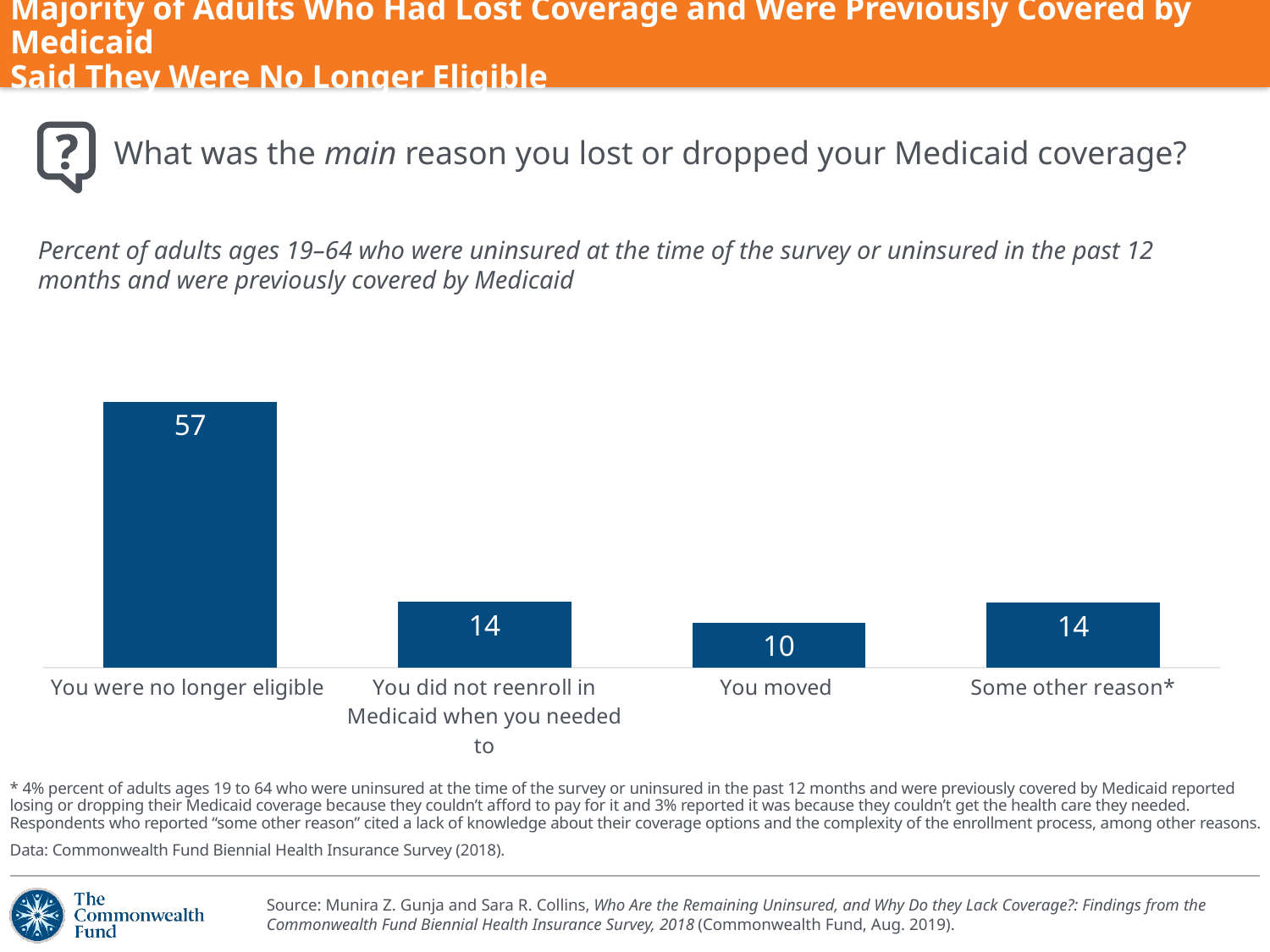
What kind of chart is shown on the slide? Bar chart Which category has the lowest value? You moved Which category has the highest value? You were no longer eligible What is the difference between the values for "You were no longer eligible" and "Some other reason*"? 43 What question does the chart's data answer, as stated on the slide? What was the main reason you lost or dropped your Medicaid coverage? What is the value for "You moved"? 10 What is the value for "You did not reenroll in Medicaid when you needed to"? 14 What is the value for "You were no longer eligible"? 57 How many categories are shown in the chart? 4 What is the difference between the values for "You were no longer eligible" and "You moved"? 47 What is the value for "Some other reason*"? 14 Which is larger, the value for "You did not reenroll in Medicaid when you needed to" or the value for "You moved"? You did not reenroll in Medicaid when you needed to